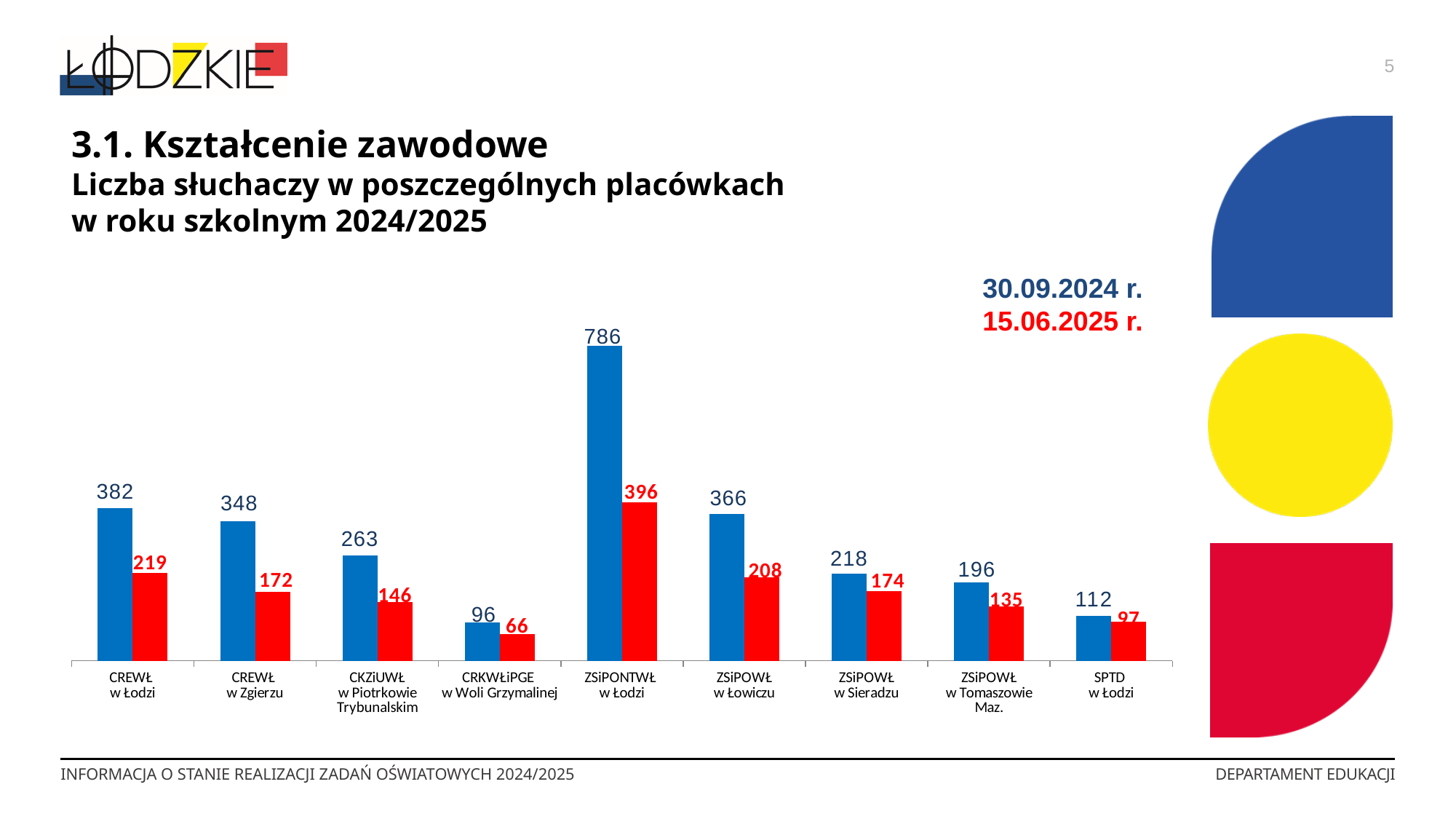
What is the difference between the 30.09.2024 r. and 15.06.2025 r. values for ZSiPONTWŁ w Łodzi? 390 What is the difference between the 30.09.2024 r. values for CREWŁ w Łodzi and CREWŁ w Zgierzu? 34 How many institutions (categories) are shown on the chart? 9 Which colour represents the 15.06.2025 r. series? red Which institution has the highest value in the 15.06.2025 r. series? ZSiPONTWŁ w Łodzi What is the value for SPTD w Łodzi in the 30.09.2024 r. series? 112 What is the value for CREWŁ w Zgierzu in the 15.06.2025 r. series? 172 Which is larger: the 15.06.2025 r. value for ZSiPOWŁ w Łowiczu or for ZSiPOWŁ w Sieradzu? ZSiPOWŁ w Łowiczu What kind of chart is shown on the slide? bar chart How many series does the chart legend list? 2 What is the value for ZSiPONTWŁ w Łodzi in the 30.09.2024 r. series? 786 Which institution has the lowest value in the 30.09.2024 r. series? CRKWŁiPGE w Woli Grzymalinej